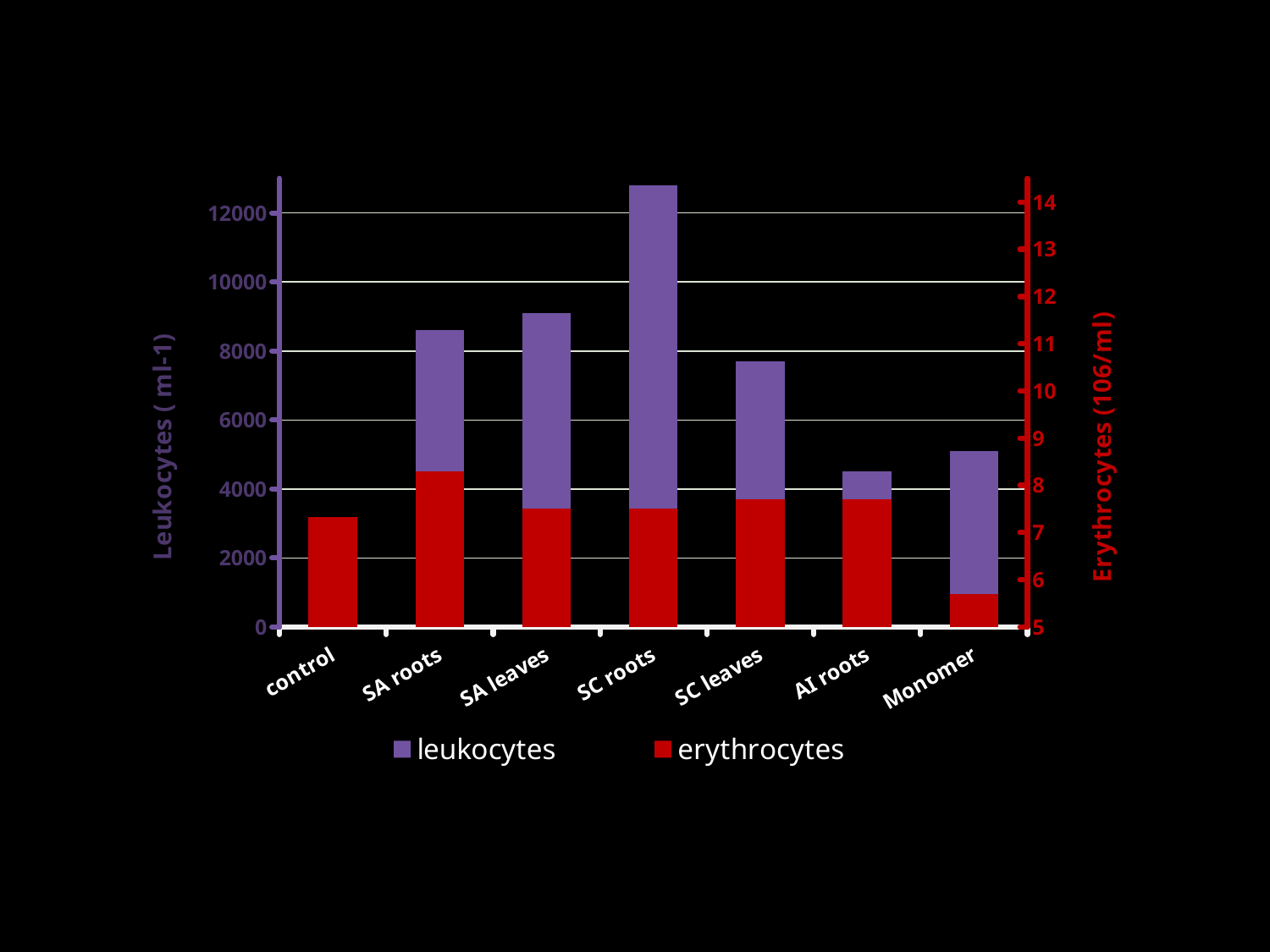
Is the top of the control bar greater or less than 4000 on the left axis? less Which category has the tallest bar overall? SC roots Is the top of the SC roots bar greater or less than 12000 on the left axis? greater Which colour represents erythrocytes in the legend? red What is the title of the left vertical axis? Leukocytes ( ml-1) How many series does the legend list? 2 Which bar is taller overall, SA leaves or SC leaves? SA leaves How many categories are shown on the x axis? 7 Which category has the shortest bar overall? control Is the top of the SC leaves bar greater or less than 6000 on the left axis? greater What kind of chart is shown on the slide? bar chart